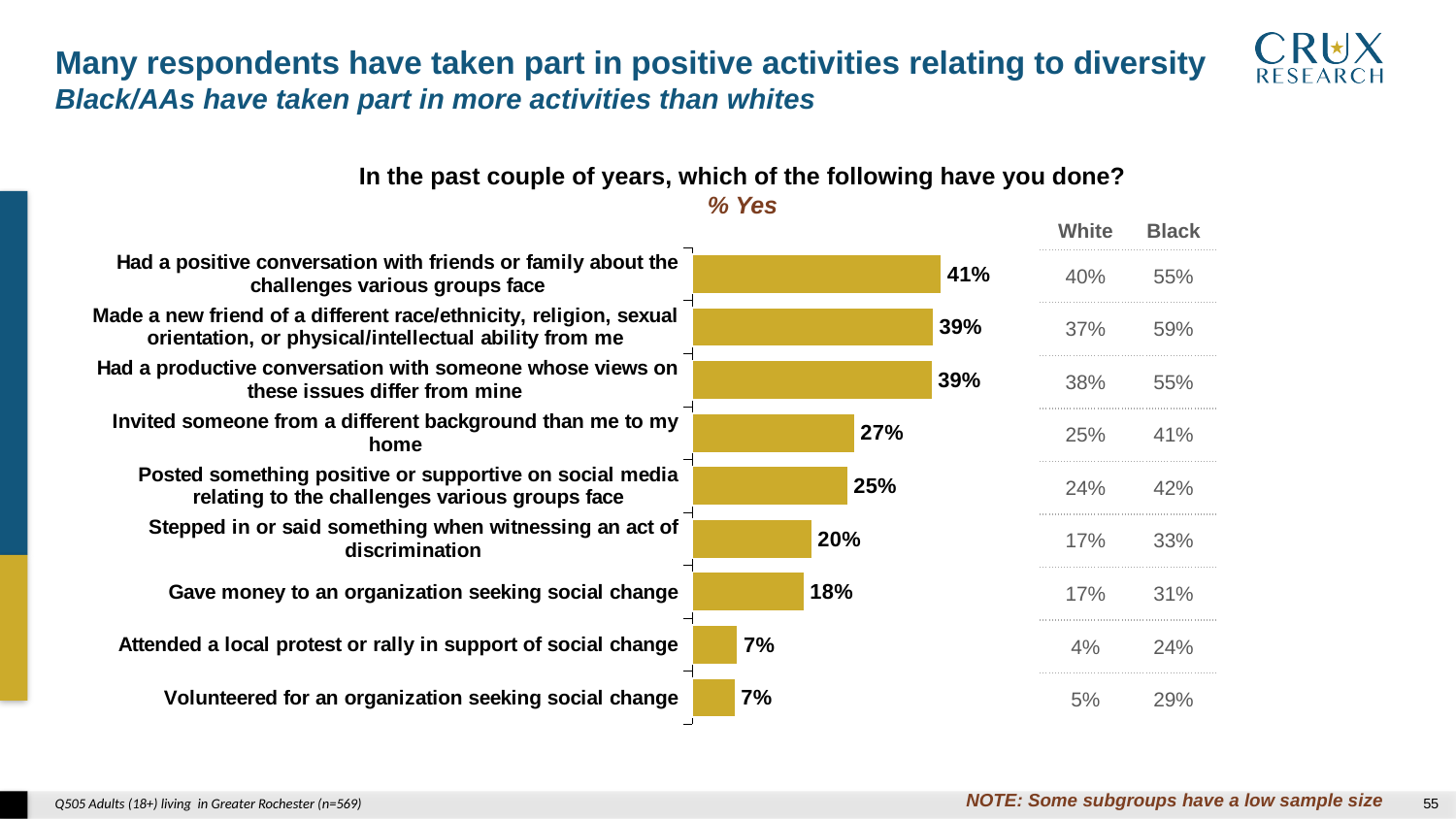
What is the value for 'Gave money to an organization seeking social change'? 18% What percentage of respondents invited someone from a different background than them to their home? 27% Which is larger: the value for 'Stepped in or said something when witnessing an act of discrimination' or 'Gave money to an organization seeking social change'? Stepped in or said something when witnessing an act of discrimination Do the values rise or fall going from the top bar to the bottom bar? Fall What kind of chart is shown on the slide? Bar chart What question is shown as the title of the chart? In the past couple of years, which of the following have you done? How many activities are listed on the chart? 9 What is the difference between the value for 'Had a positive conversation with friends or family about the challenges various groups face' and 'Invited someone from a different background than me to my home'? 14 percentage points What is the value for 'Stepped in or said something when witnessing an act of discrimination'? 20% What is the lowest value shown on the chart? 7% Which activity has the highest percentage of respondents saying yes? Had a positive conversation with friends or family about the challenges various groups face What percentage of respondents had a positive conversation with friends or family about the challenges various groups face? 41%